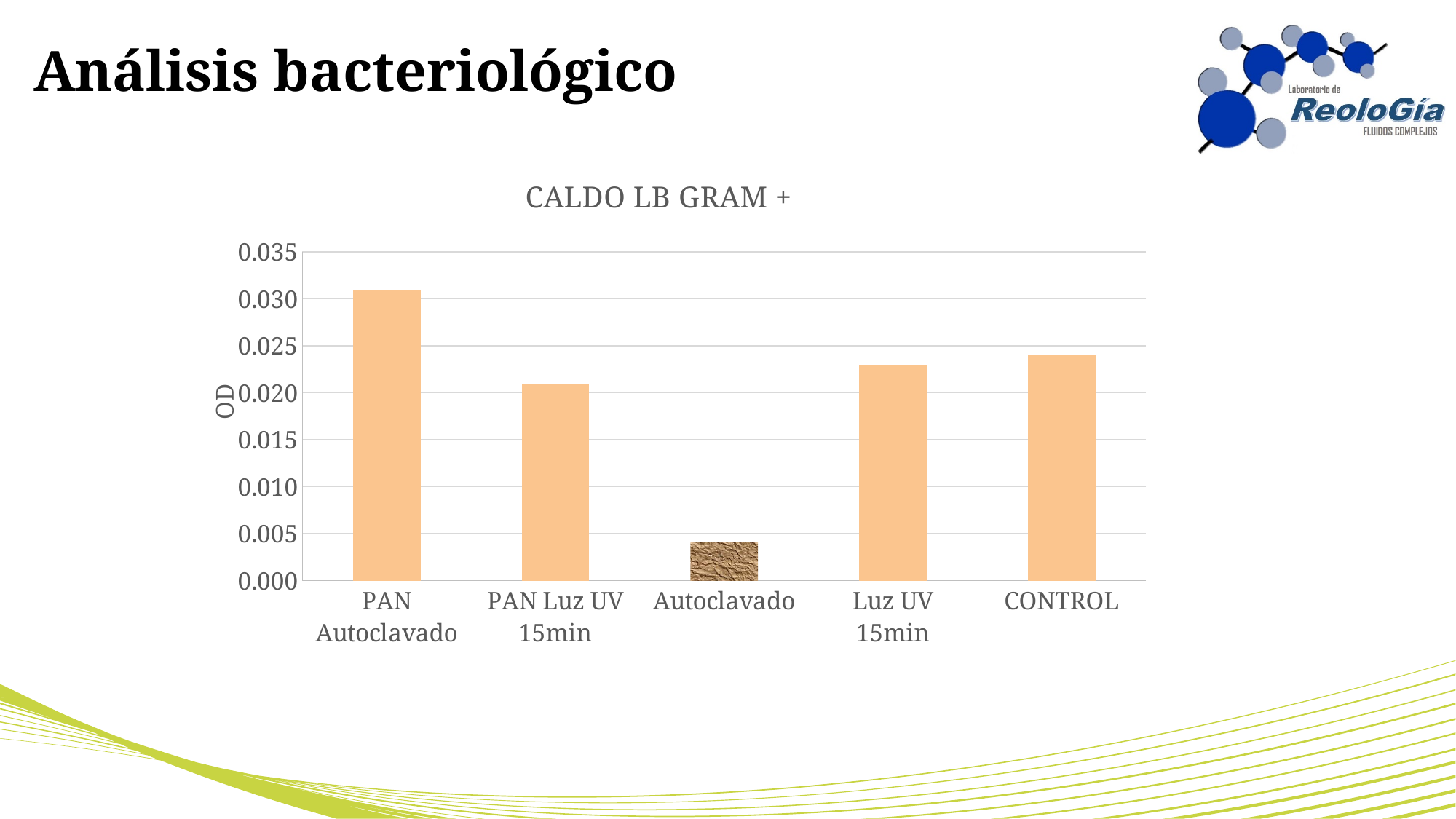
Which has a larger OD value, Autoclavado or CONTROL? CONTROL Is the value for CONTROL greater or less than 0.020? greater Which category has the lowest OD value? Autoclavado Which has a larger OD value, PAN Autoclavado or PAN Luz UV 15min? PAN Autoclavado Which category has the highest OD value? PAN Autoclavado Is the value for PAN Autoclavado greater or less than 0.025? greater How many categories are shown on the x axis? 5 Is the value for PAN Luz UV 15min greater or less than 0.025? less What is the title of the chart? CALDO LB GRAM + What is the label of the vertical axis? OD What type of chart is shown on the slide? bar chart